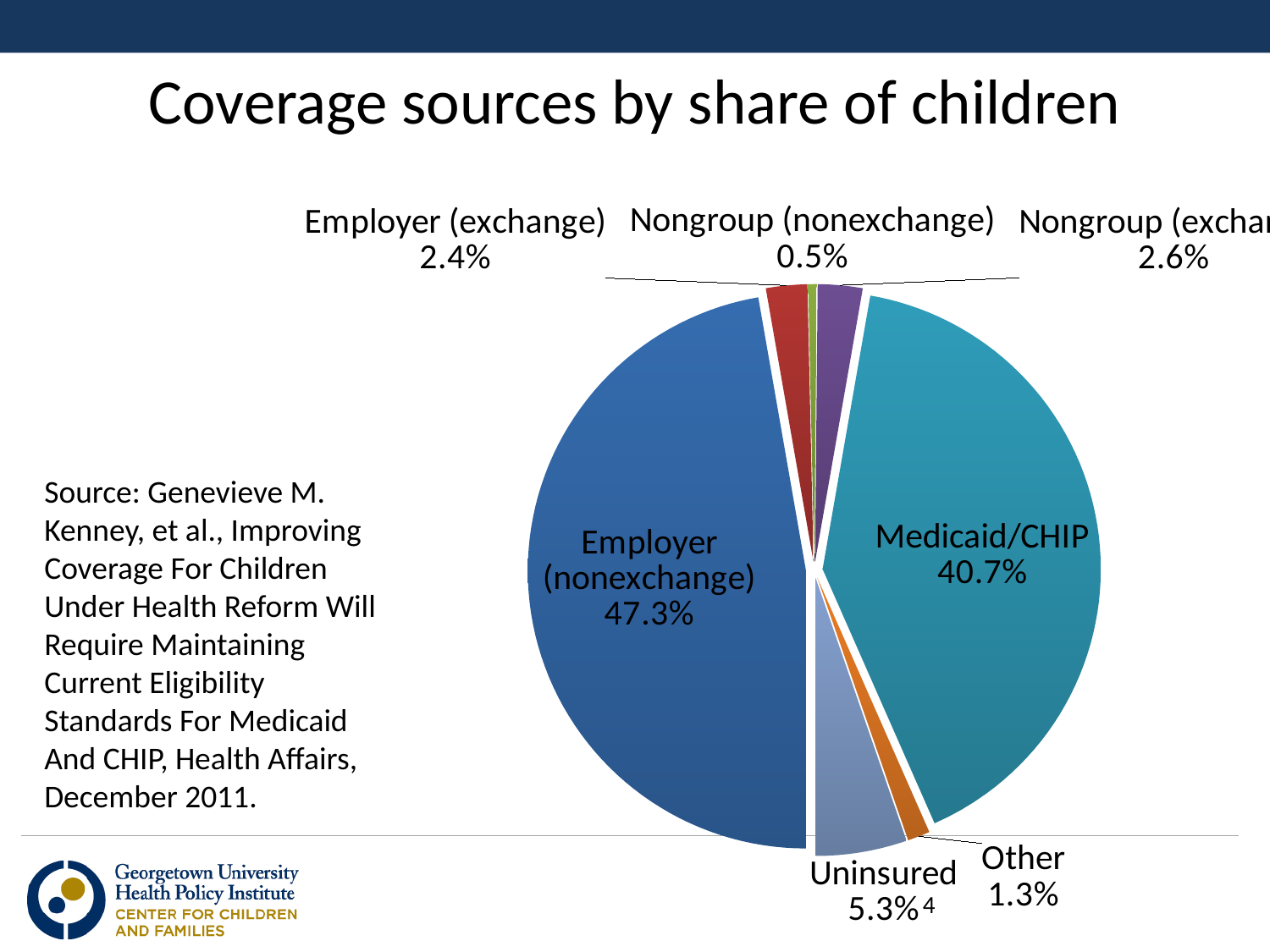
What share of children is covered by Employer (nonexchange)? 47.3% How many slices does the pie chart have? 7 What share of children is Uninsured? 5.3% Which is larger, the share for Uninsured or the share for Other? Uninsured What share of children is covered by Nongroup (nonexchange)? 0.5% What share of children is covered by Medicaid/CHIP? 40.7% Which coverage source has the largest share of children? Employer (nonexchange) What is the difference in share between Employer (nonexchange) and Medicaid/CHIP? 6.6% What share of children is covered by Employer (exchange)? 2.4% Which coverage source has the smallest share of children? Nongroup (nonexchange) What kind of chart is shown on the slide? Pie chart What share of children falls under Other? 1.3%